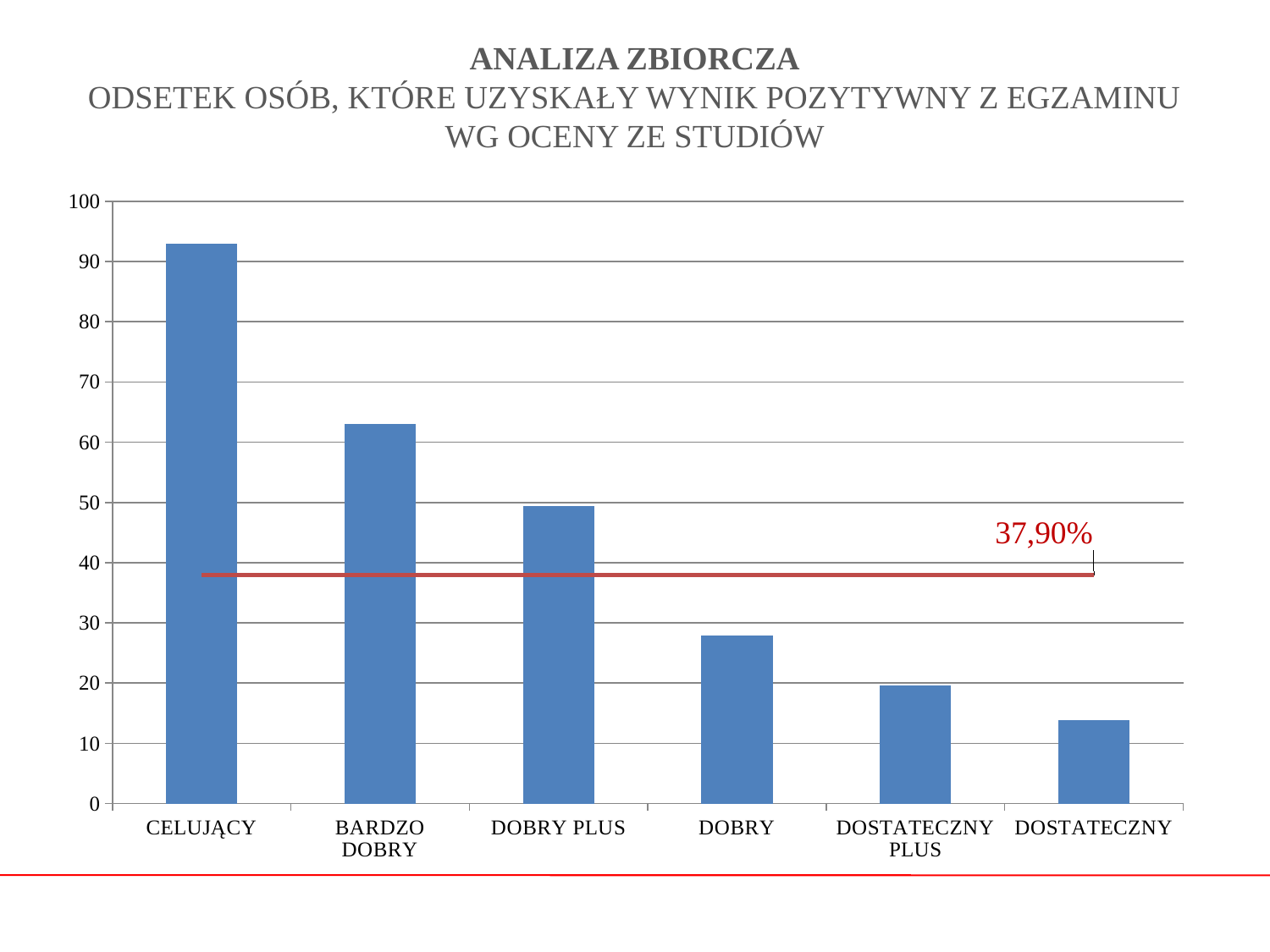
What value is labelled on the red horizontal reference line? 37,90% Is the value for CELUJĄCY greater or less than 90? greater Is the value for DOSTATECZNY greater or less than 20? less How many categories are shown on the x axis? 6 Do the bar values rise or fall from left to right along the x axis? fall Is the value for BARDZO DOBRY greater or less than 60? greater What kind of chart is shown on the slide? bar chart Which category has the lowest bar? DOSTATECZNY Which is larger, the value for DOBRY or the value for DOSTATECZNY PLUS? DOBRY Which category has the highest bar? CELUJĄCY Which is larger, the value for BARDZO DOBRY or the value for DOBRY PLUS? BARDZO DOBRY